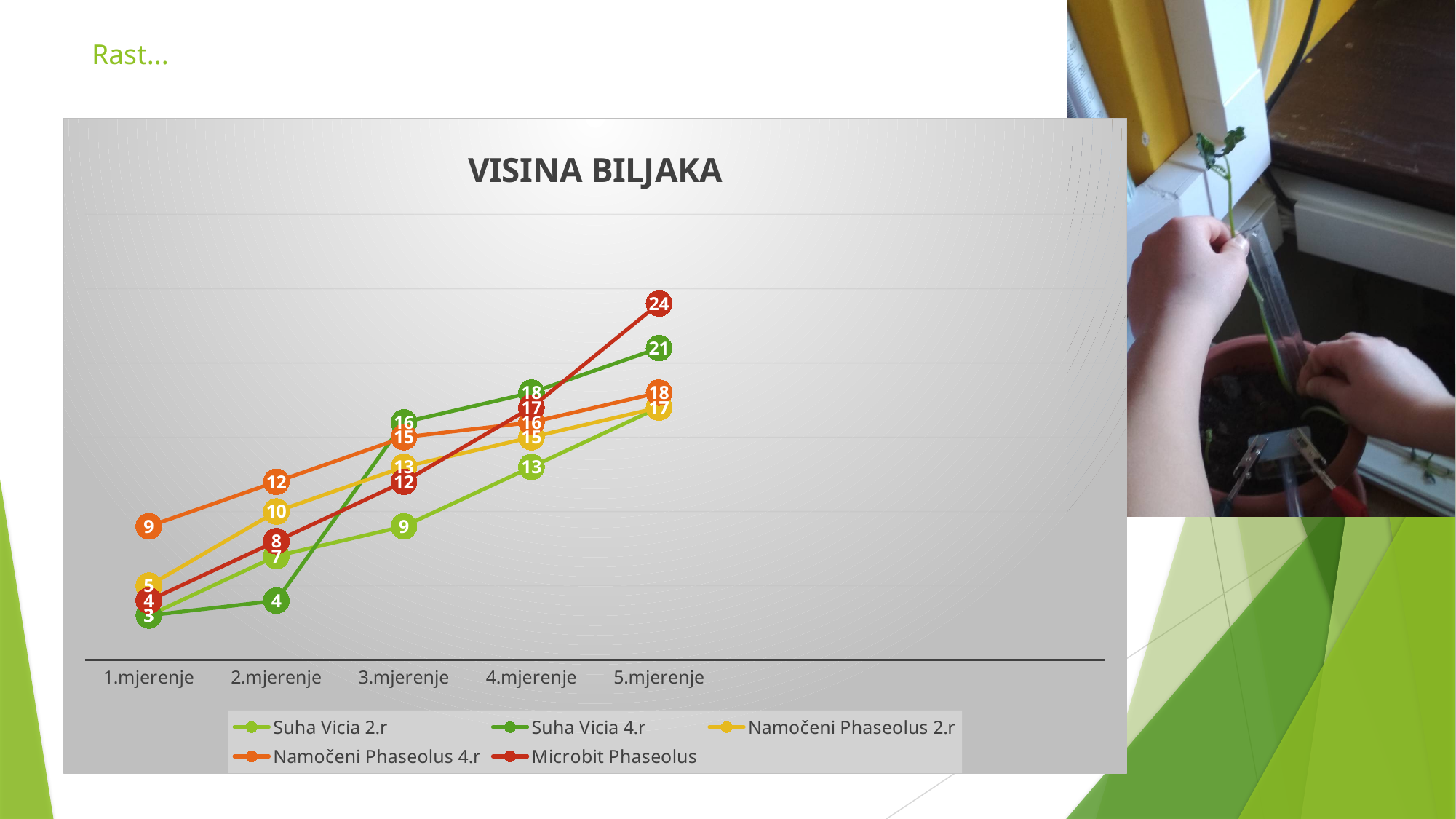
Which series has the lowest value at 2.mjerenje? Suha Vicia 4.r What is the difference between the Microbit Phaseolus values at 5.mjerenje and 1.mjerenje? 20 At 4.mjerenje, which is larger: Suha Vicia 4.r or Suha Vicia 2.r? Suha Vicia 4.r What is the value for Namočeni Phaseolus 4.r at 1.mjerenje? 9 Do the values for Suha Vicia 2.r rise or fall from 1.mjerenje to 5.mjerenje? rise Which series has the highest value at 5.mjerenje? Microbit Phaseolus How many series does the legend of the VISINA BILJAKA chart list? 5 What is the value for Microbit Phaseolus at 5.mjerenje? 24 What is the value for Namočeni Phaseolus 2.r at 3.mjerenje? 13 How many measurement points (categories) are shown on the x axis? 5 What type of chart is shown on the slide? line chart What is the value for Suha Vicia 4.r at 2.mjerenje? 4